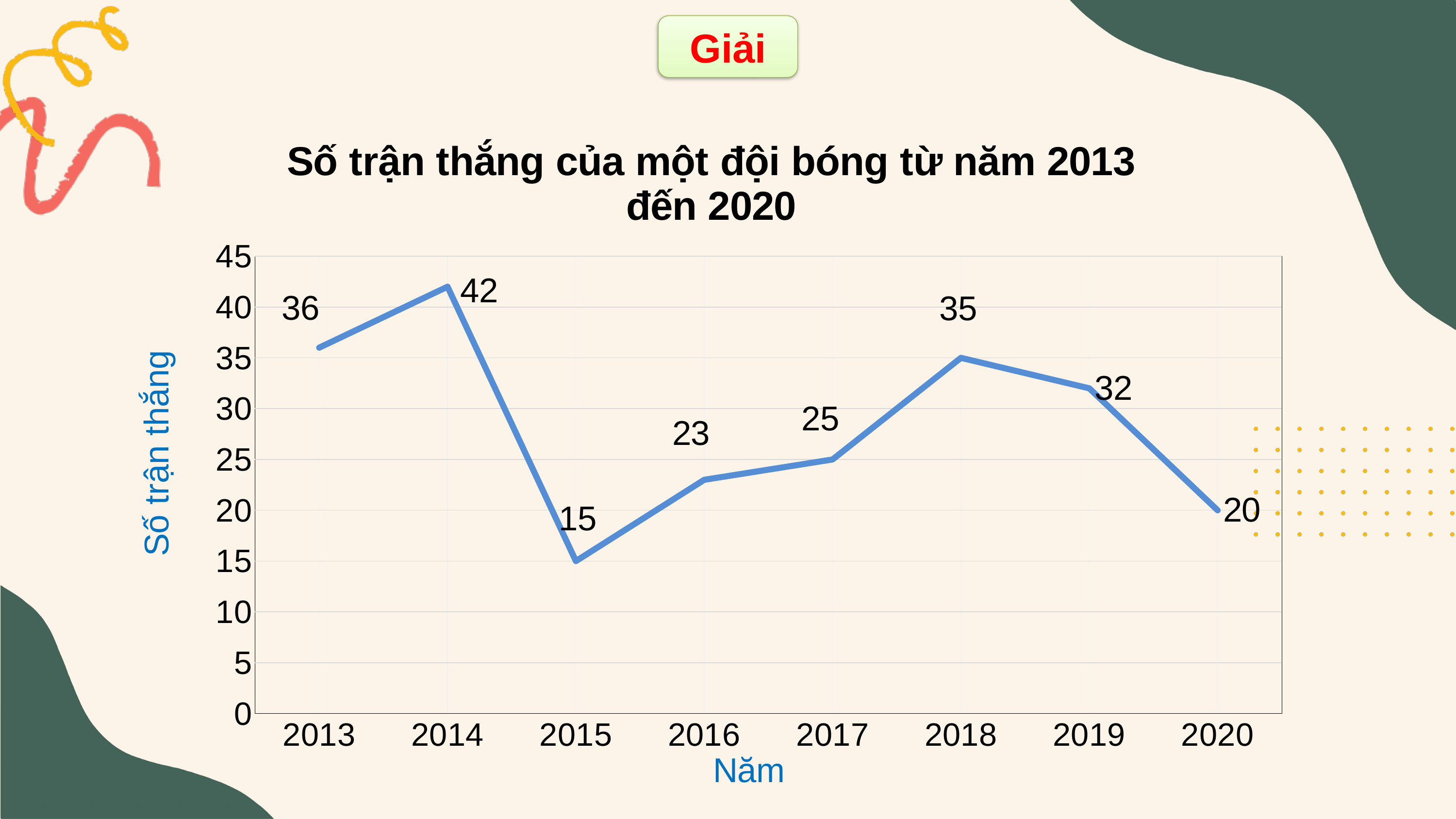
What is the label of the vertical axis? Số trận thắng Which year has the highest number of wins? 2014 What is the difference between the number of wins in 2014 and in 2015? 27 Is the value for 2016 greater or less than 25? less What is the value plotted for 2017? 25 What is the difference between the values for 2018 and 2019? 3 How many years are plotted on the chart? 8 What kind of chart is shown on the slide? line chart Do the values rise or fall from 2018 to 2020? fall How many wins did the team have in 2014? 42 Which year has the lowest number of wins? 2015 Which year had more wins, 2013 or 2018? 2013